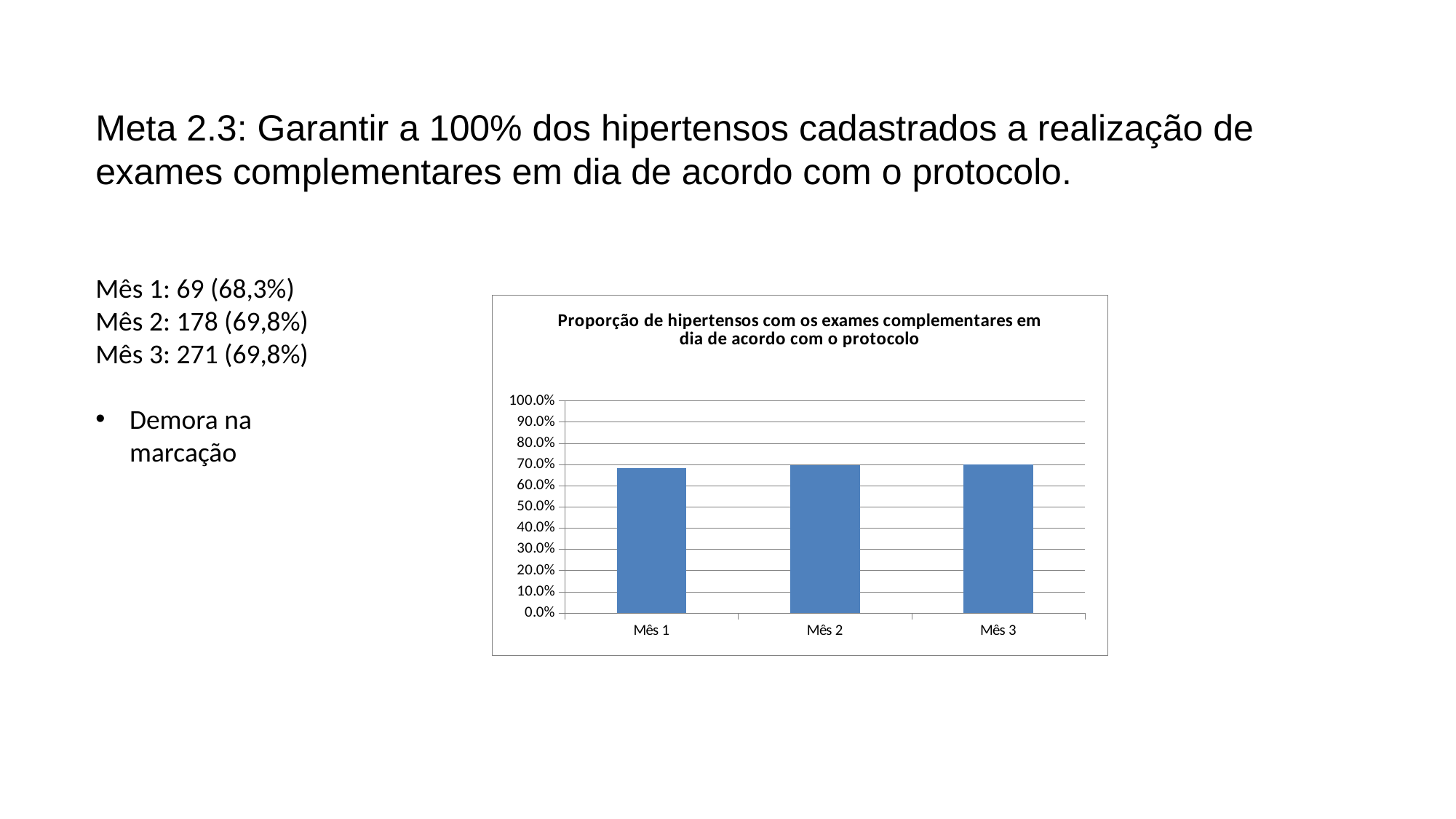
How many categories (months) are plotted on the chart? 3 Is the value for Mês 3 greater or less than 80%? less Is the value for Mês 1 greater or less than 70%? less What kind of chart is shown on the slide? bar chart What is the label of the last category on the x axis? Mês 3 Is the value for Mês 3 greater or less than 60%? greater What is the title of the chart? Proporção de hipertensos com os exames complementares em dia de acordo com o protocolo What is the highest value shown on the chart's vertical axis? 100.0% What is the label of the first category on the x axis? Mês 1